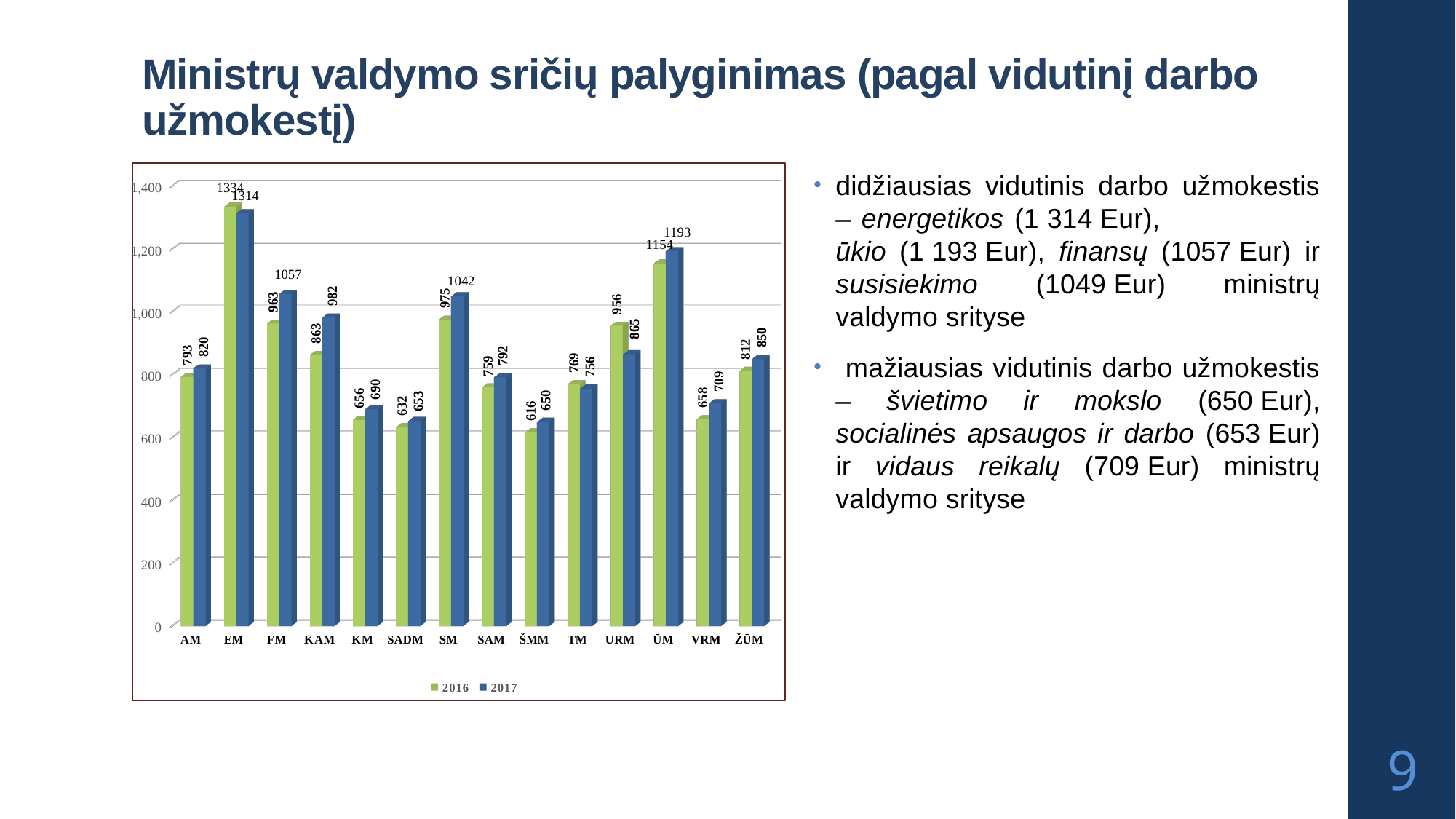
What is the 2017 value for ŠMM? 650 How many series does the legend list? 2 Is the 2017 value for ŪM greater or less than 1,000? greater What is the 2017 value for FM? 1057 Which category has the lowest 2016 value? ŠMM What is the difference between the 2017 and 2016 values for KAM? 119 What is the 2016 value for URM? 956 Which category has the highest 2017 value? EM Which is larger for TM: the 2016 value or the 2017 value? 2016 How many categories are shown on the x axis? 14 What kind of chart is shown on the slide? bar chart Which series is shown in green in the legend? 2016